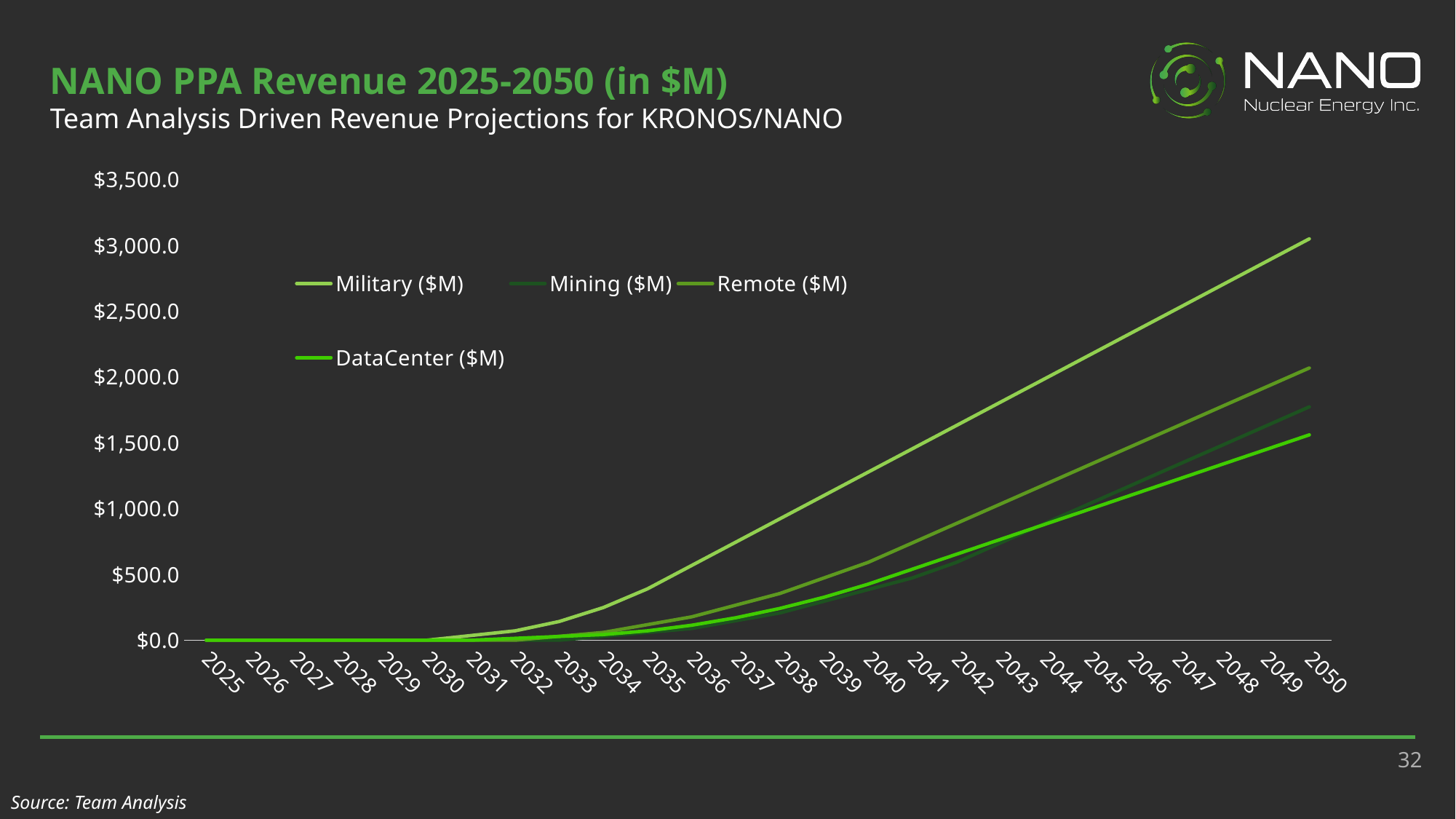
Which series has the highest value in 2050? Military ($M) Is the value for Military ($M) in 2040 greater or less than $1,000.0? greater Do the values for Military ($M) rise or fall from 2025 to 2050? Rise What is the title of the chart? NANO PPA Revenue 2025-2050 (in $M) Which series has the lowest value in 2050? DataCenter ($M) Is the value for Military ($M) in 2050 greater or less than $2,500.0? greater How many series does the legend list? 4 In 2050, which is larger: Military ($M) or Mining ($M)? Military ($M) How many years are plotted along the x axis? 26 What kind of chart is shown on the slide? Line chart In 2050, which is larger: Mining ($M) or Remote ($M)? Remote ($M)